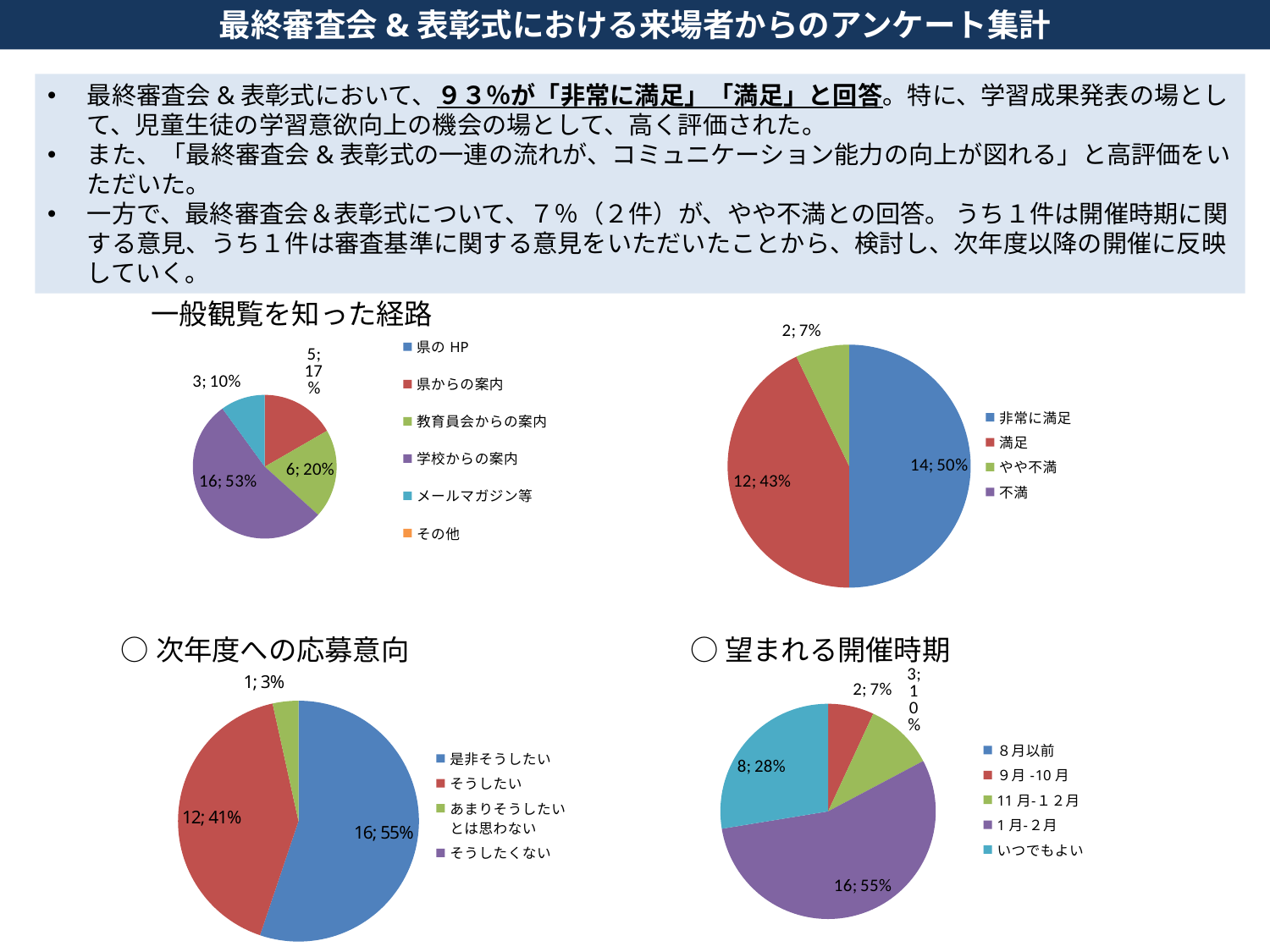
In the top-right pie chart, what is the value shown for 非常に満足? 14; 50% In the 一般観覧を知った経路 chart, which category has the largest slice? 学校からの案内 In the 次年度への応募意向 chart, what is the value for 是非そうしたい? 16; 55% What kind of chart is used for 望まれる開催時期? pie chart In the 次年度への応募意向 chart, which category has the smallest slice? あまりそうしたいとは思わない In the 望まれる開催時期 chart, which category has the largest slice? 1月-2月 In the 望まれる開催時期 chart, which is larger, 9月-10月 or 11月-12月? 11月-12月 In the 次年度への応募意向 chart, what is the difference in count between 是非そうしたい and そうしたい? 4 In the top-right pie chart, what share of the pie is やや不満? 7% In the top-right pie chart, how many entries does the legend list? 4 In the top-right pie chart, what is the value shown for 満足? 12; 43% In the 望まれる開催時期 chart, what is the value for いつでもよい? 8; 28%